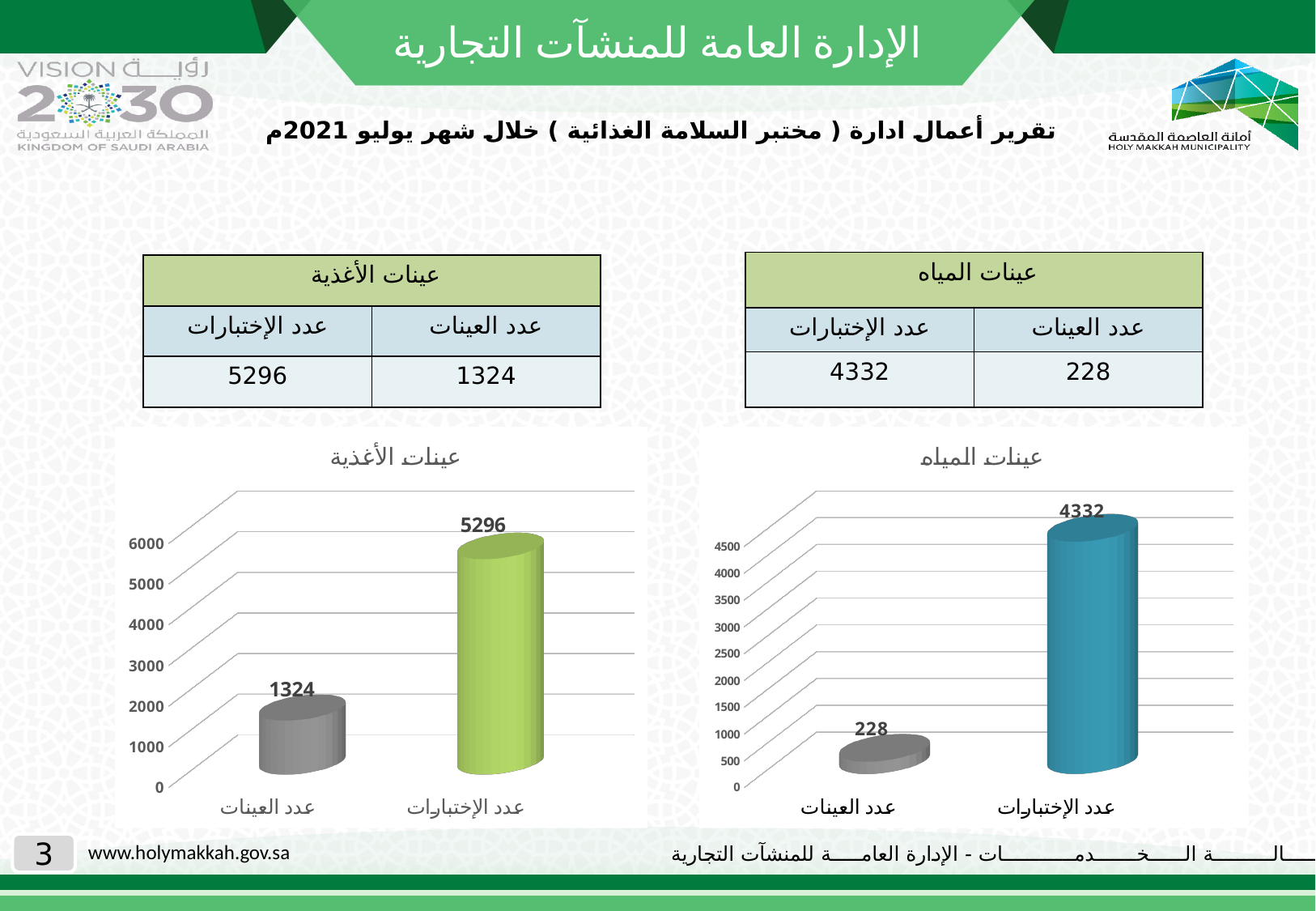
In the chart titled عينات الأغذية, what is the value for عدد العينات? 1324 Which is larger: عدد العينات in the chart titled عينات الأغذية or عدد العينات in the chart titled عينات المياه? عينات الأغذية How many categories are shown in the chart titled عينات الأغذية? 2 In the chart titled عينات الأغذية, what is the value for عدد الإختبارات? 5296 In the chart titled عينات المياه, what is the value for عدد العينات? 228 In the chart titled عينات الأغذية, which category has the highest value? عدد الإختبارات In the chart titled عينات المياه, what is the value for عدد الإختبارات? 4332 What type of chart is the chart titled عينات المياه? bar chart In the chart titled عينات المياه, which category has the lowest value? عدد العينات In the chart titled عينات المياه, is the value for عدد الإختبارات greater or less than 4000? greater In the chart titled عينات المياه, what is the difference between عدد الإختبارات and عدد العينات? 4104 In the chart titled عينات الأغذية, what is the difference between عدد الإختبارات and عدد العينات? 3972